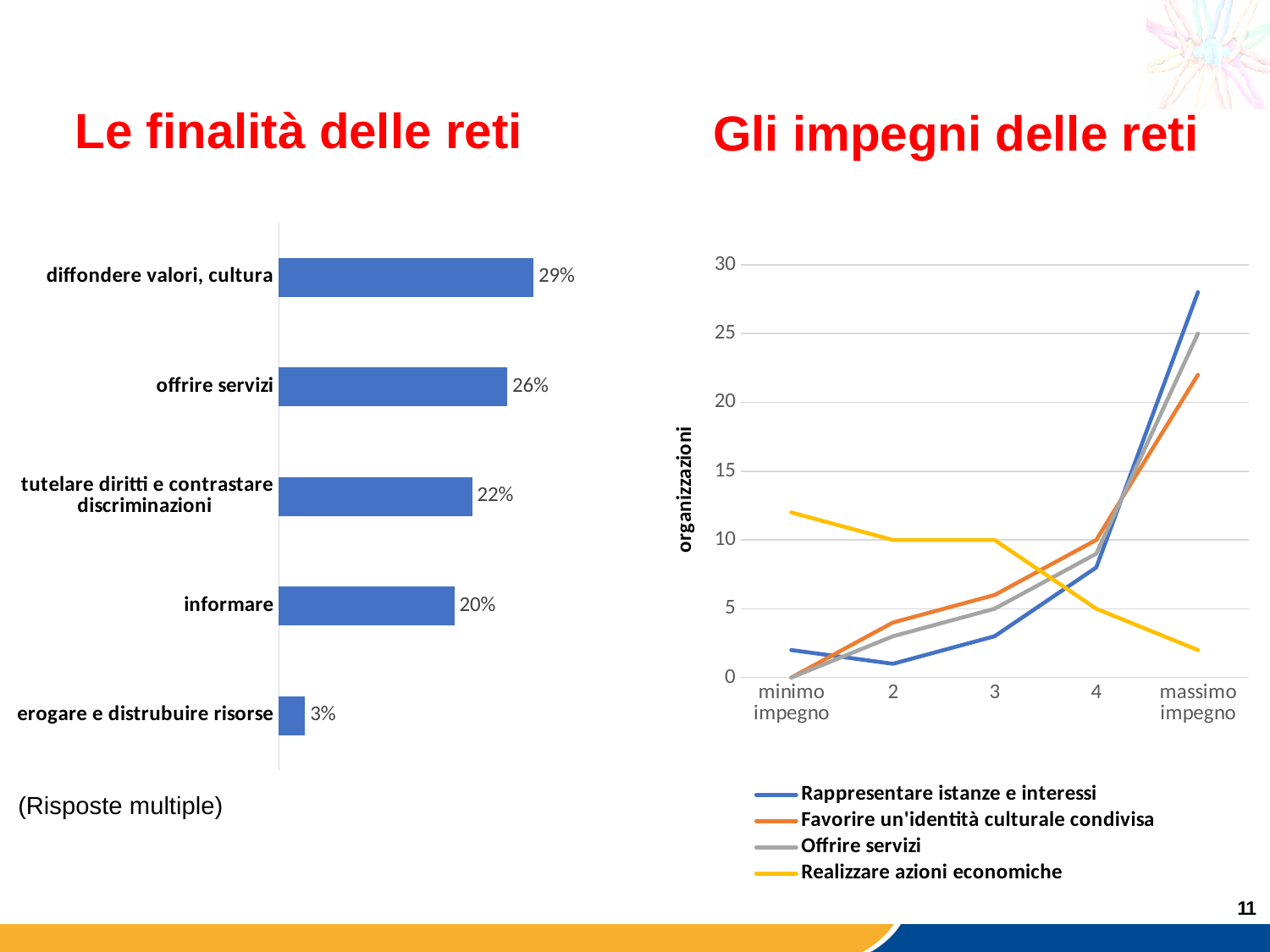
What kind of chart is the one titled "Le finalità delle reti"? bar chart In the chart titled "Le finalità delle reti", what is the value for "diffondere valori, cultura"? 29% In the chart titled "Le finalità delle reti", what is the difference between "offrire servizi" and "tutelare diritti e contrastare discriminazioni"? 4% In the chart titled "Gli impegni delle reti", is the value for "Rappresentare istanze e interessi" at "massimo impegno" greater or less than 25? greater In the chart titled "Le finalità delle reti", which category has the lowest value? erogare e distrubuire risorse In the chart titled "Le finalità delle reti", how many categories are shown? 5 In the chart titled "Gli impegni delle reti", how many series does the legend list? 4 In the chart titled "Gli impegni delle reti", does the "Realizzare azioni economiche" series rise or fall from "minimo impegno" to "massimo impegno"? fall In the chart titled "Le finalità delle reti", what is the value for "informare"? 20% In the chart titled "Gli impegni delle reti", is the value for "Realizzare azioni economiche" at "massimo impegno" greater or less than 5? less In the chart titled "Le finalità delle reti", which category has the highest value? diffondere valori, cultura In the chart titled "Gli impegni delle reti", what is the label of the vertical axis? organizzazioni